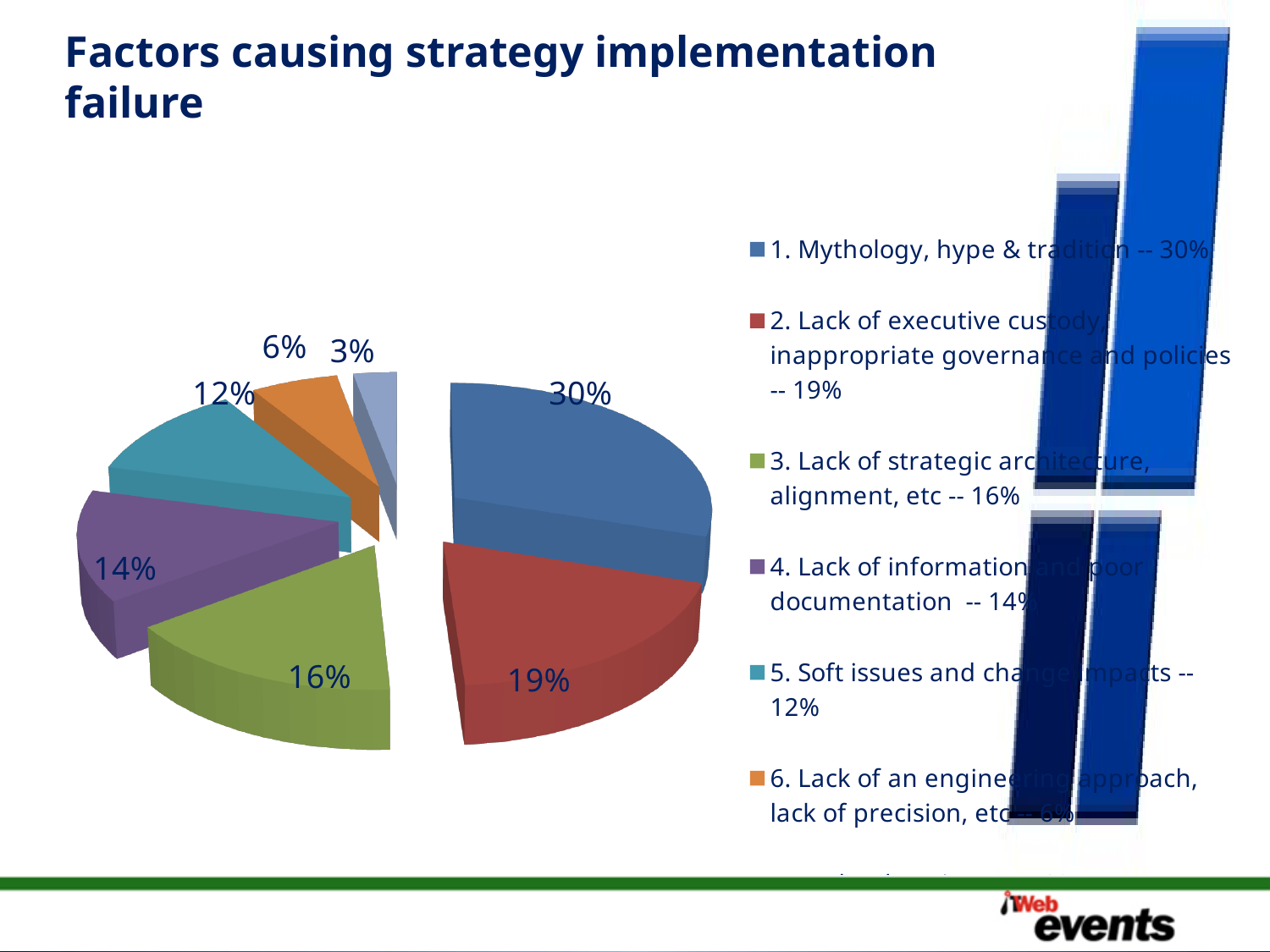
What percentage is shown for "3. Lack of strategic architecture, alignment, etc"? 16% What percentage is shown for "5. Soft issues and change impacts"? 12% How many slices does the pie chart have? 7 What kind of chart is shown on the slide? pie chart What is the smallest percentage labelled on the pie chart? 3% What is the difference in percentage points between "1. Mythology, hype & tradition" and "2. Lack of executive custody, inappropriate governance and policies"? 11 Which factor has the largest slice of the pie? 1. Mythology, hype & tradition What percentage is shown for "1. Mythology, hype & tradition"? 30% What percentage is shown for "6. Lack of an engineering approach, lack of precision, etc"? 6% Which is larger: the slice for "4. Lack of information and poor documentation" or the slice for "5. Soft issues and change impacts"? 4. Lack of information and poor documentation What is the title of the slide containing the chart? Factors causing strategy implementation failure What colour is the slice for "2. Lack of executive custody, inappropriate governance and policies"? red